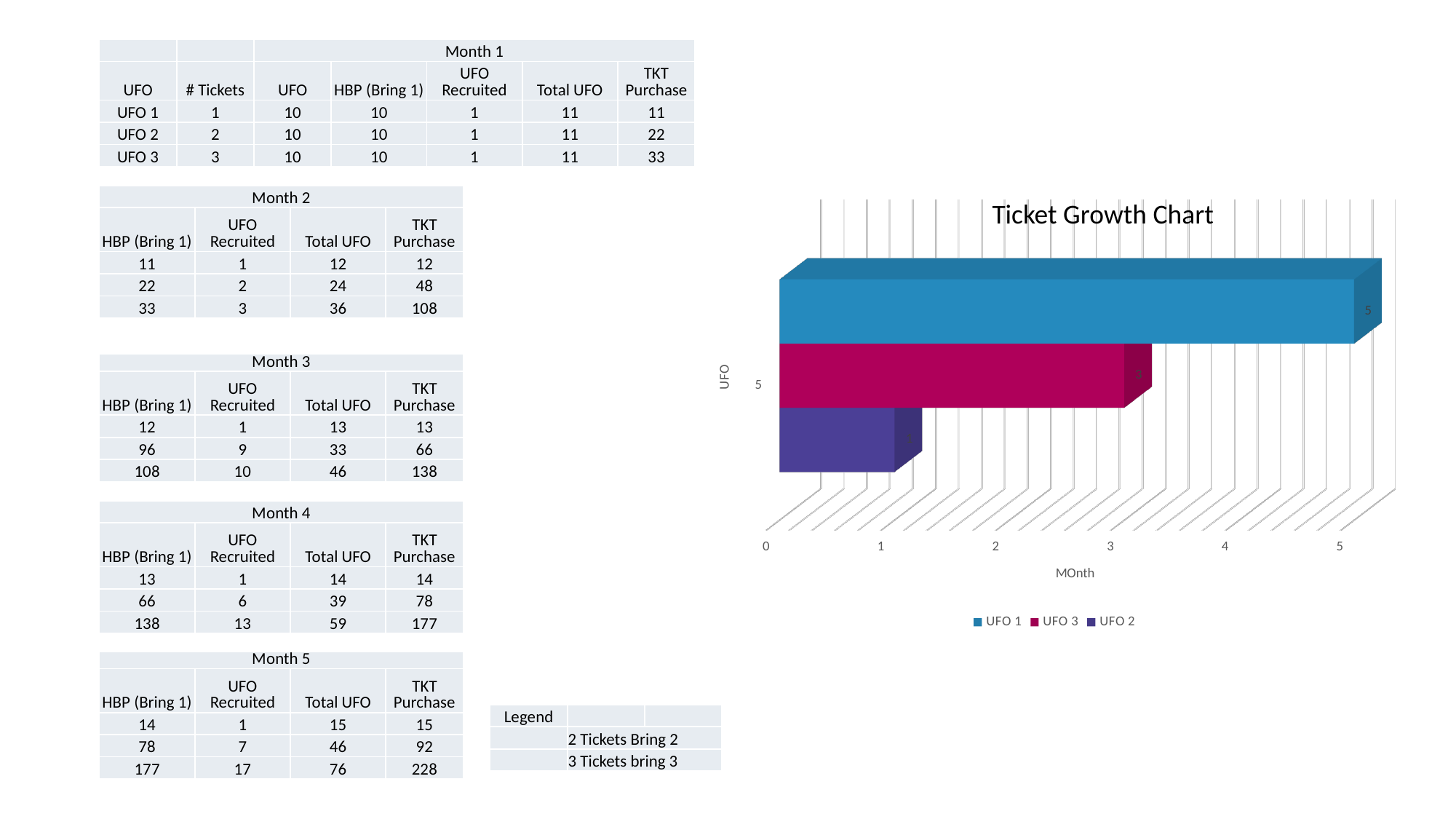
In the Ticket Growth Chart, what is the value labelled on the UFO 3 bar? 3 In the Ticket Growth Chart, what is the value labelled on the UFO 2 bar? 1 In the Ticket Growth Chart, what is the difference between the UFO 1 value and the UFO 3 value? 2 What kind of chart is the Ticket Growth Chart? bar chart In the Ticket Growth Chart, what is the value labelled on the UFO 1 bar? 5 What is the label of the horizontal axis of the Ticket Growth Chart? MOnth How many series does the legend of the Ticket Growth Chart list? 3 In the Ticket Growth Chart, which is larger, the UFO 3 value or the UFO 2 value? UFO 3 In the Ticket Growth Chart, is the value for UFO 3 greater or less than 2? greater In the Ticket Growth Chart, which series has the longest bar? UFO 1 What is the title of the chart on the slide? Ticket Growth Chart In the Ticket Growth Chart, which series has the shortest bar? UFO 2